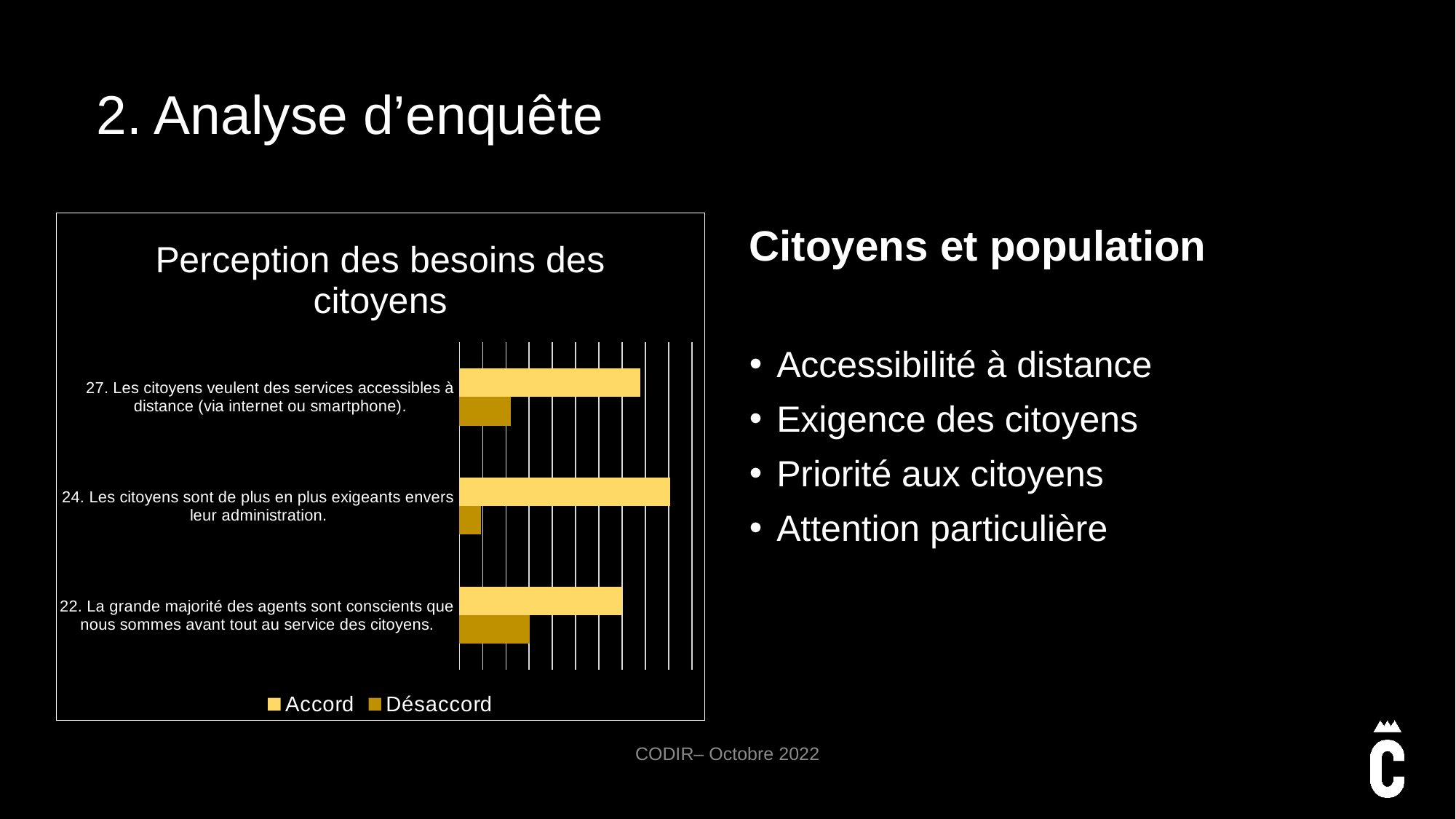
How many series does the chart legend list? 2 Which is larger: the Accord value for statement 24 or the Accord value for statement 27? statement 24 What is the title of the chart? Perception des besoins des citoyens Which statement has the lowest Désaccord value? 24. Les citoyens sont de plus en plus exigeants envers leur administration. Which statement has the highest Accord value? 24. Les citoyens sont de plus en plus exigeants envers leur administration. Which statement has the highest Désaccord value? 22. La grande majorité des agents sont conscients que nous sommes avant tout au service des citoyens. How many statements (categories) are plotted in the chart? 3 What kind of chart is shown on the slide? bar chart Which is larger: the Désaccord value for statement 22 or the Désaccord value for statement 27? statement 22 What are the two series named in the chart legend? Accord and Désaccord Which statement has the lowest Accord value? 22. La grande majorité des agents sont conscients que nous sommes avant tout au service des citoyens. For statement 27, which is larger: Accord or Désaccord? Accord